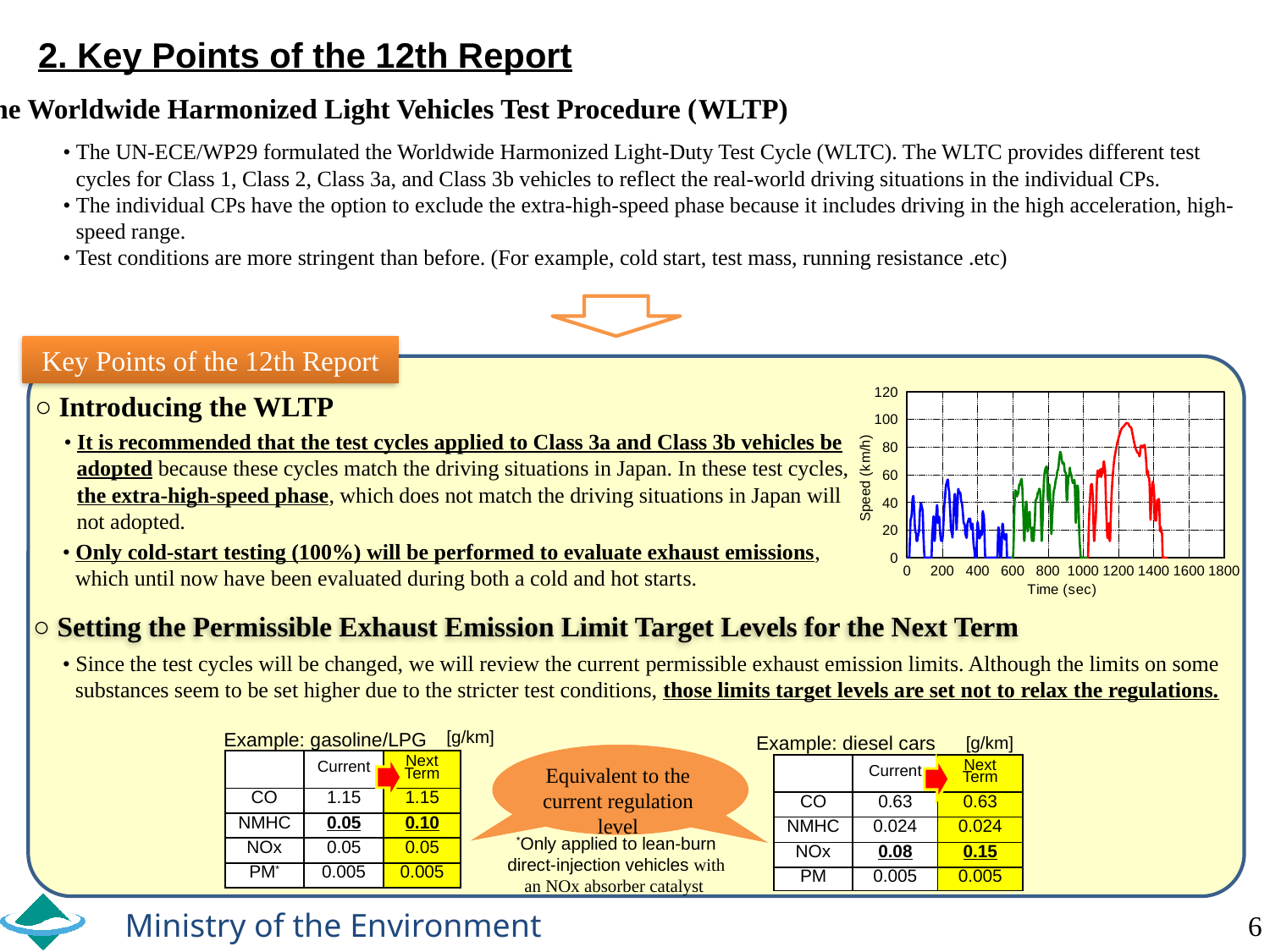
On the speed-versus-time chart, is the peak speed of the red segment greater or less than 80? greater On the speed-versus-time chart, which coloured segment reaches the highest speed? red How many differently coloured line segments are plotted on the speed-versus-time chart? 3 On the speed-versus-time chart, what is the highest value shown on the horizontal axis? 1800 On the speed-versus-time chart, is the peak speed of the blue segment greater or less than 80? less On the speed-versus-time chart, what is the highest value shown on the vertical axis? 120 What is the label of the vertical axis of the speed-versus-time chart? Speed (km/h) What kind of chart is shown on the right side of the slide, plotting speed against time? line chart On the speed-versus-time chart, do the peak speeds of the segments rise or fall as time increases along the x axis? rise On the speed-versus-time chart, which coloured segment has the lowest peak speed? blue On the speed-versus-time chart, is the peak speed of the green segment greater or less than 100? less What is the label of the horizontal axis of the speed-versus-time chart? Time (sec)